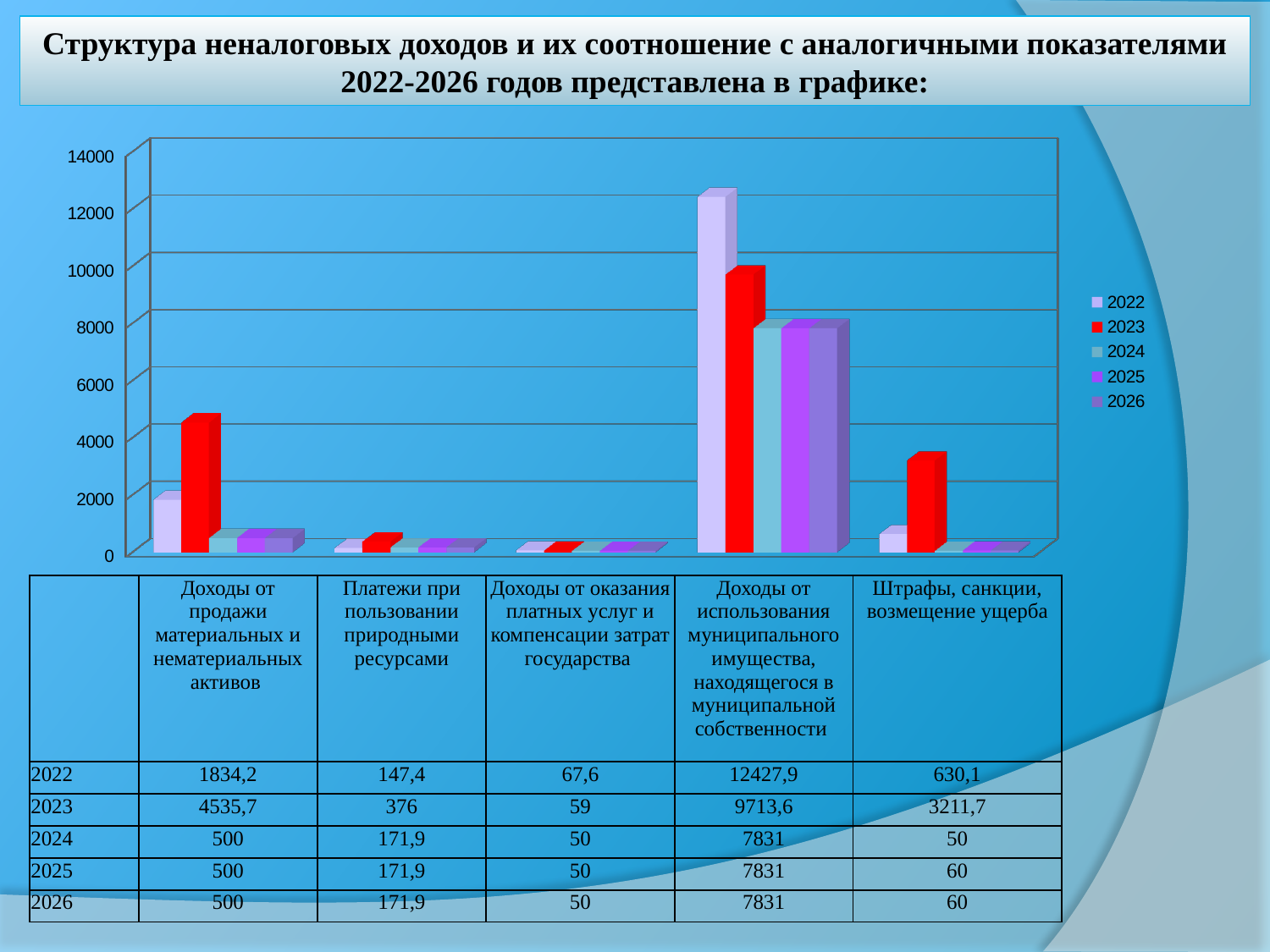
What type of chart is shown on the slide? Bar chart Which category has the lowest value for 2023? Доходы от оказания платных услуг и компенсации затрат государства Which series is shown in red in the legend? 2023 How many series does the legend list? 5 What is the value for 2023 in the category «Штрафы, санкции, возмещение ущерба»? 3211,7 Is the 2022 value for «Доходы от использования муниципального имущества, находящегося в муниципальной собственности» greater or less than 12000? greater What is the difference between the 2022 and 2023 values for «Доходы от использования муниципального имущества, находящегося в муниципальной собственности»? 2714,3 Which is larger for «Доходы от продажи материальных и нематериальных активов»: the 2022 value or the 2023 value? 2023 How many categories are plotted on the x axis? 5 Which category has the highest value for 2022? Доходы от использования муниципального имущества, находящегося в муниципальной собственности What is the value for 2024 in the category «Платежи при пользовании природными ресурсами»? 171,9 What is the value for 2022 in the category «Доходы от использования муниципального имущества, находящегося в муниципальной собственности»? 12427,9